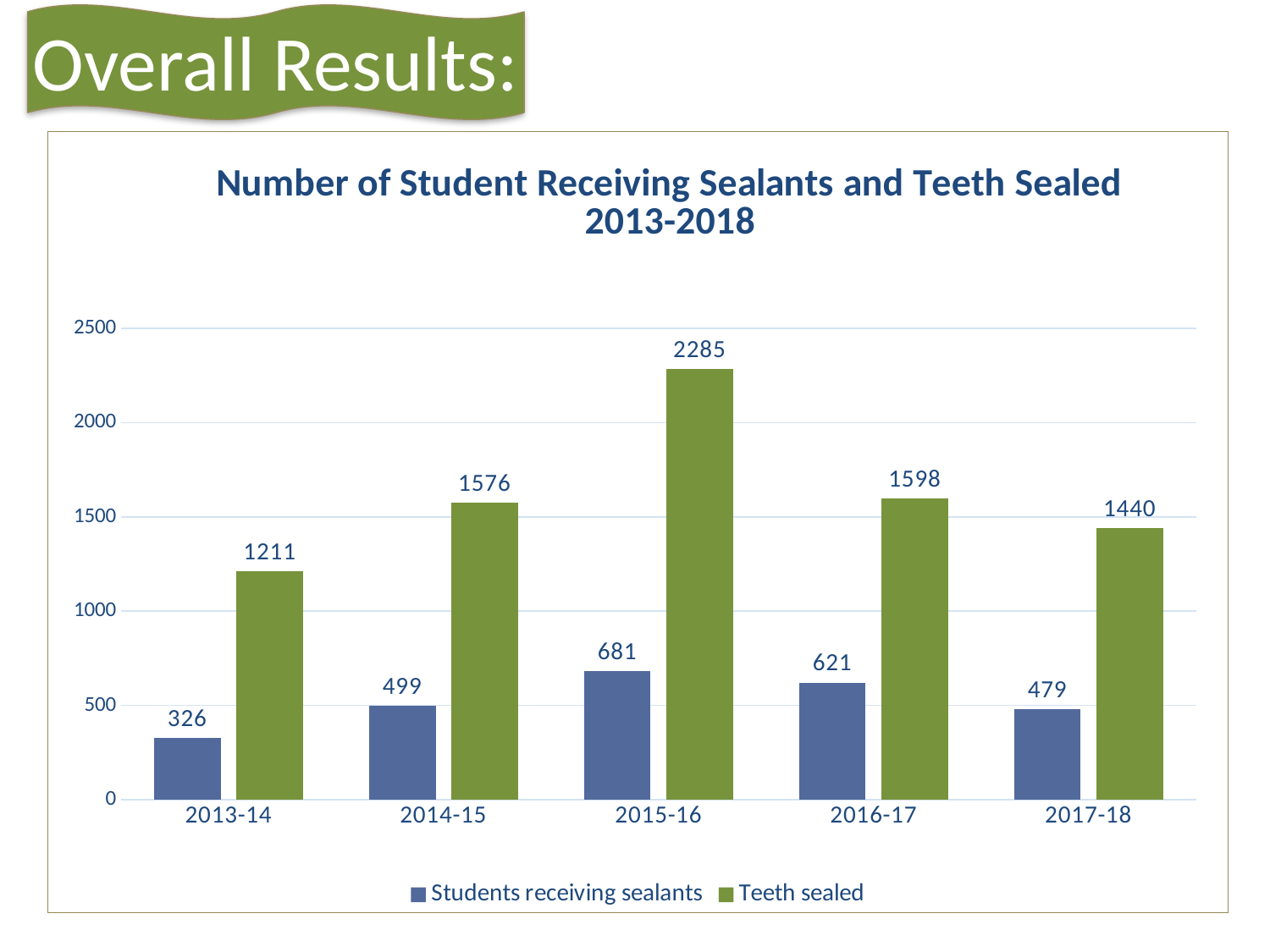
How many school years are shown on the x axis? 5 Which year had more students receiving sealants, 2014-15 or 2017-18? 2014-15 Did the number of students receiving sealants rise or fall from 2015-16 to 2017-18? Fall How many students received sealants in 2015-16? 681 How many series does the legend list? 2 What is the difference between the number of teeth sealed in 2015-16 and in 2016-17? 687 How many teeth were sealed in 2017-18? 1440 What is the title of the chart? Number of Student Receiving Sealants and Teeth Sealed 2013-2018 Is the value for teeth sealed in 2014-15 greater or less than 1500? greater In which school year was the number of students receiving sealants lowest? 2013-14 In which school year was the number of teeth sealed highest? 2015-16 What kind of chart is shown on the slide? Bar chart